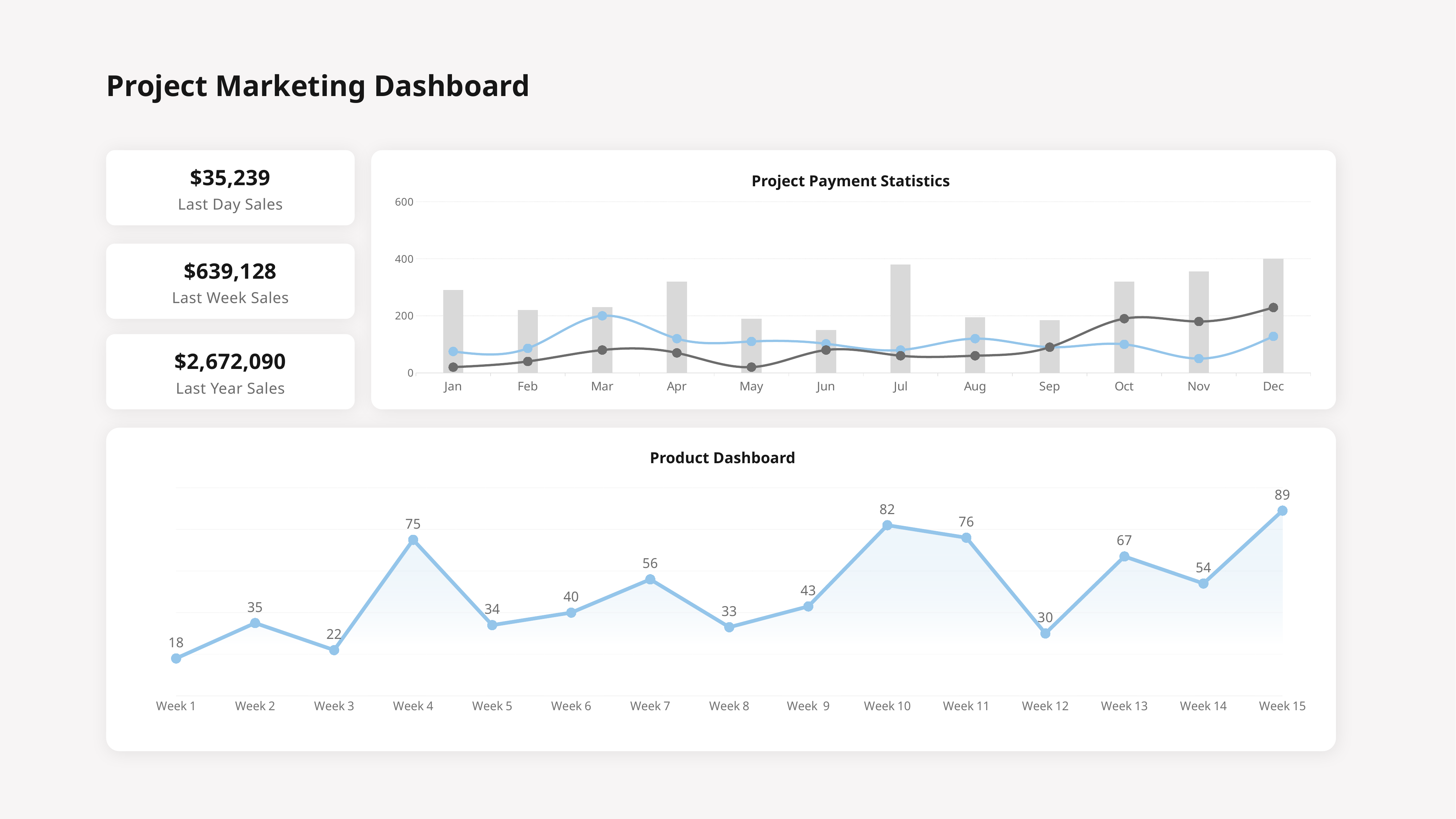
On the Product Dashboard chart, do the values rise or fall from Week 8 to Week 10? rise On the Project Payment Statistics chart, is the bar for Jul greater or less than 200? greater On the Project Payment Statistics chart, how many months are shown on the x axis? 12 What kind of chart is the Product Dashboard chart? line chart On the Project Payment Statistics chart, which month has the lowest bar? Jun On the Product Dashboard chart, what is the difference between the values for Week 10 and Week 1? 64 On the Product Dashboard chart, which week has the highest value? Week 15 On the Product Dashboard chart, what is the value for Week 4? 75 On the Product Dashboard chart, how many weeks are plotted? 15 On the Product Dashboard chart, which is larger, the value for Week 4 or the value for Week 7? Week 4 On the Product Dashboard chart, which week has the lowest value? Week 1 On the Product Dashboard chart, what is the value for Week 13? 67